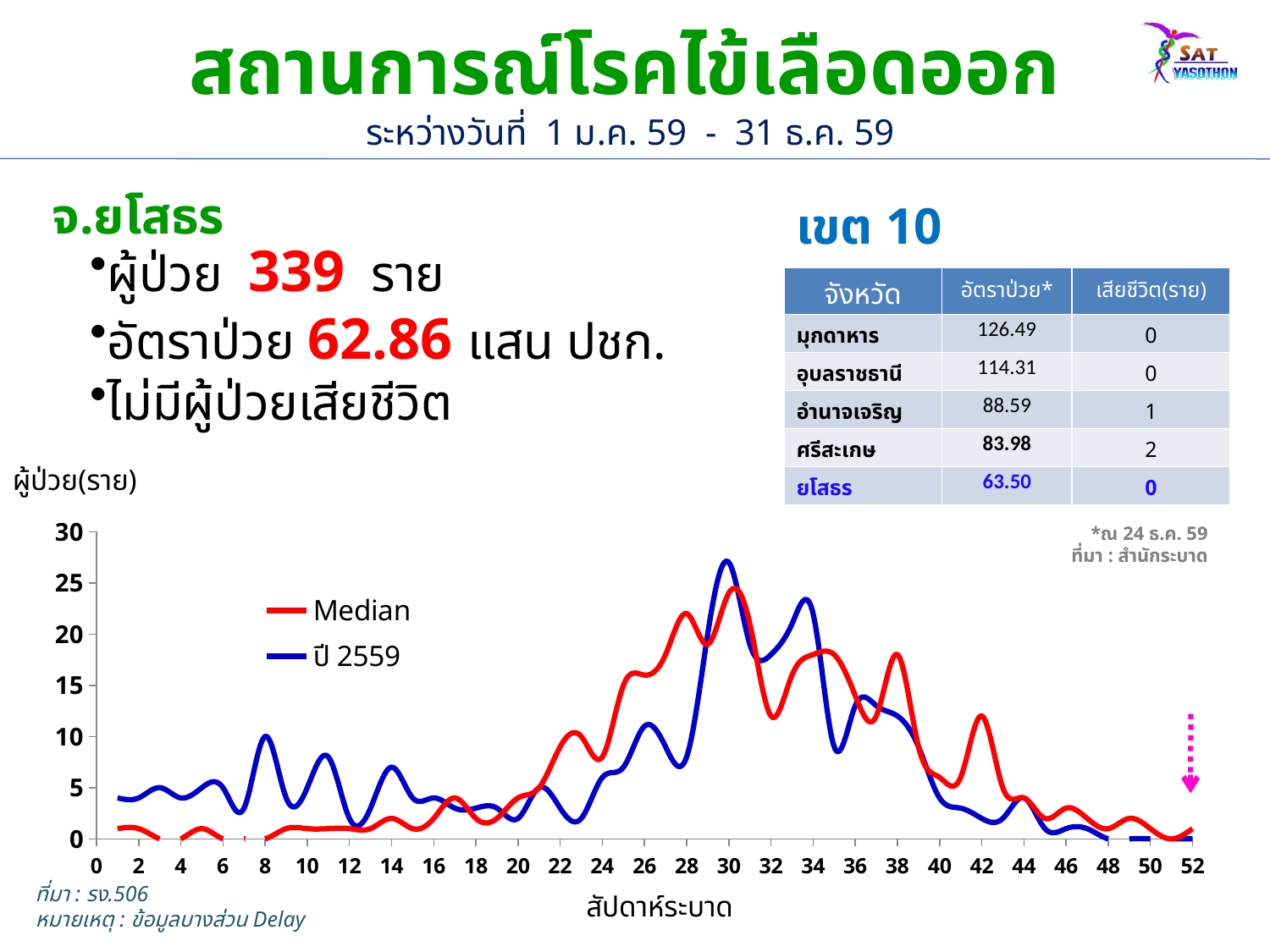
What kind of chart is shown on the slide? line chart Is the value of the Median series at week 8 greater or less than 5? less Is the value of the ปี 2559 series at week 22 greater or less than 5? less How many series does the chart legend list? 2 Is the value of the ปี 2559 series at week 30 greater or less than 25? greater What is the label on the x axis of the chart? สัปดาห์ระบาด At week 30, which series has the higher value, Median or ปี 2559? ปี 2559 What are the two series named in the chart legend? Median and ปี 2559 Do the values of the ปี 2559 series rise or fall from week 30 to week 48? fall